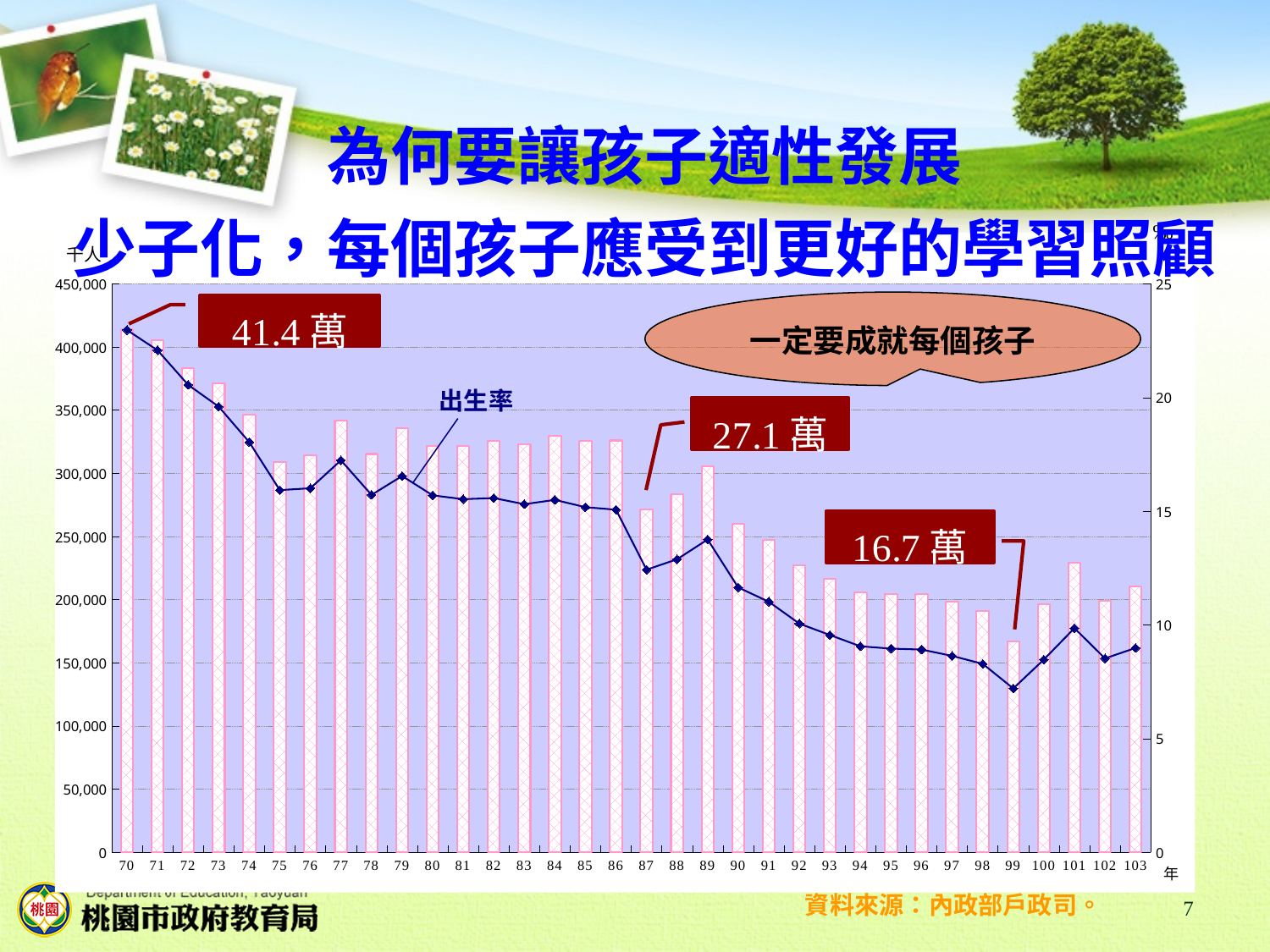
Which year has the shortest bar? 99 Which bar is taller, year 87 or year 99? 87 What value does the callout give for the bar at year 70? 41.4 萬 Is the bar value for year 70 greater or less than 400,000? greater What is the difference between the callout values for year 70 and year 87? 14.3 萬 What label is attached to the line series in the chart? 出生率 What kind of chart is shown on the slide? A combined bar and line chart What value does the callout give for the bar at year 87? 27.1 萬 Is the bar value for year 99 greater or less than 200,000? less What value does the callout give for the bar at year 99? 16.7 萬 How many years are shown along the x axis of the chart? 34 Which year has the tallest bar? 70